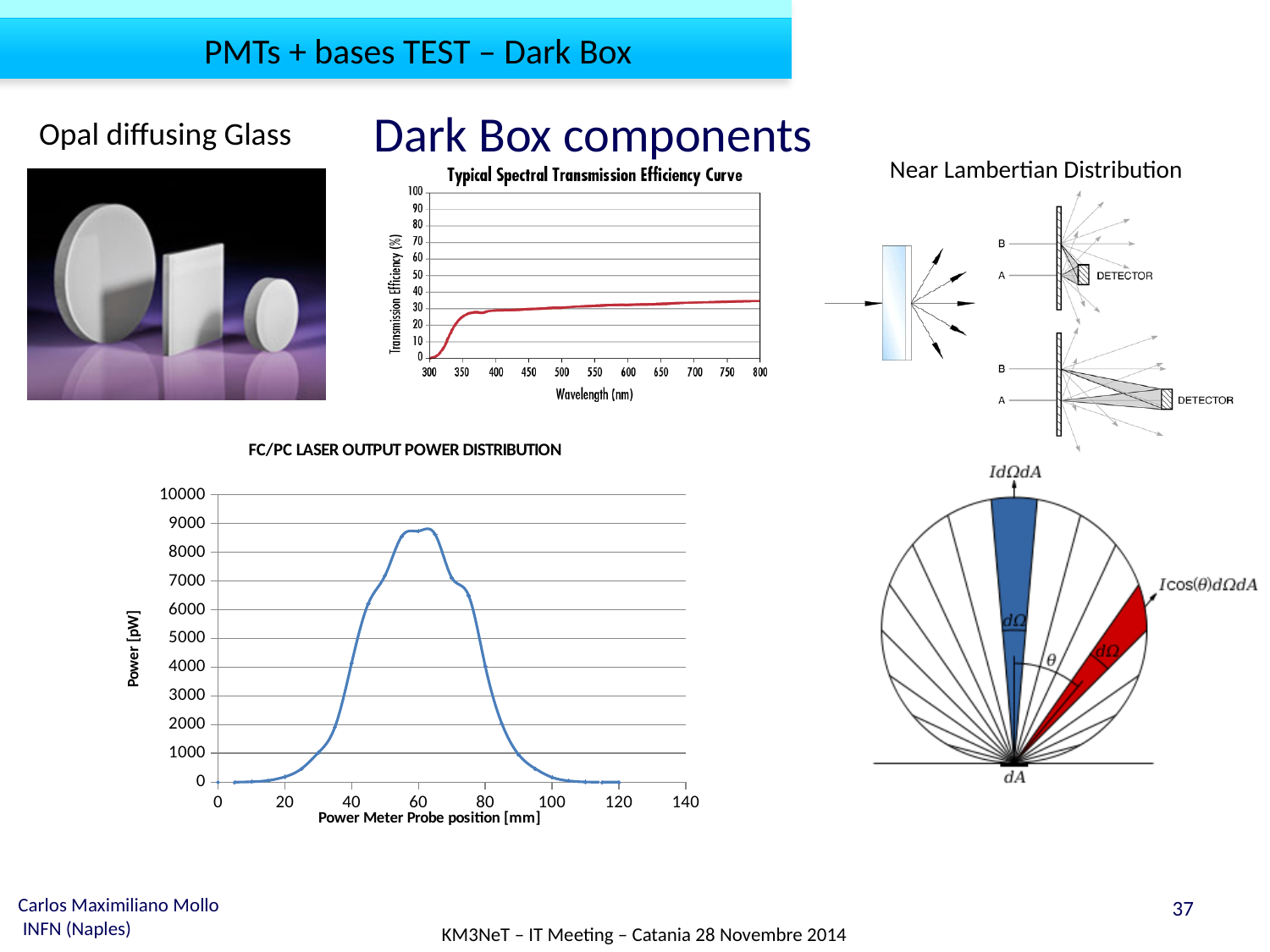
In the FC/PC LASER OUTPUT POWER DISTRIBUTION chart, is the power at a probe position of 20 mm greater or less than 1000 pW? less In the FC/PC LASER OUTPUT POWER DISTRIBUTION chart, is the power higher at a probe position of 60 mm or at 20 mm? 60 mm In the FC/PC LASER OUTPUT POWER DISTRIBUTION chart, does the power rise or fall as the probe position goes from 0 mm to 60 mm? rise In the FC/PC LASER OUTPUT POWER DISTRIBUTION chart, is the power at a probe position of 60 mm greater or less than 8000 pW? greater What kind of chart is the FC/PC LASER OUTPUT POWER DISTRIBUTION chart? line chart In the FC/PC LASER OUTPUT POWER DISTRIBUTION chart, does the power rise or fall as the probe position goes from 60 mm to 120 mm? fall In the Typical Spectral Transmission Efficiency Curve chart, is the transmission efficiency at 500 nm greater or less than 20%? greater What is the y-axis label of the FC/PC LASER OUTPUT POWER DISTRIBUTION chart? Power [pW] What is the x-axis label of the FC/PC LASER OUTPUT POWER DISTRIBUTION chart? Power Meter Probe position [mm] In the Typical Spectral Transmission Efficiency Curve chart, does the transmission efficiency rise or fall as the wavelength goes from 400 nm to 800 nm? rise